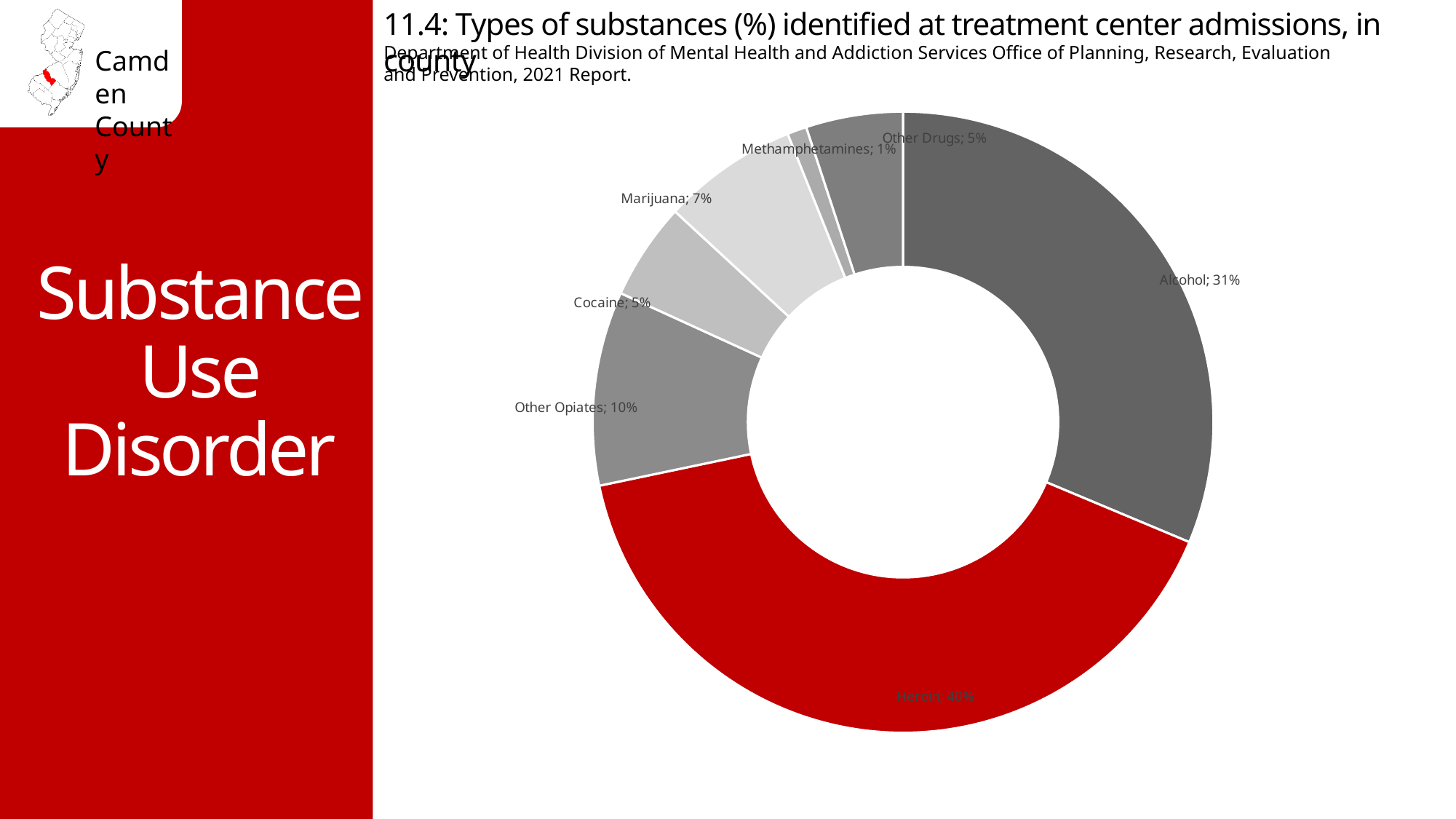
What percentage is shown for Other Opiates? 10% Which has a larger share, Other Opiates or Marijuana? Other Opiates How many substance categories are shown in the chart? 7 What percentage is shown for Marijuana? 7% Which substance has the smallest share of treatment center admissions? Methamphetamines What is the difference in percentage points between Heroin and Alcohol? 9 Which slice of the chart is coloured red? Heroin Which substance has the largest share of treatment center admissions? Heroin What percentage of treatment center admissions is attributed to Heroin? 40% What kind of chart is used on this slide? Doughnut (pie) chart What percentage is shown for Methamphetamines? 1% What percentage of treatment center admissions is attributed to Alcohol? 31%